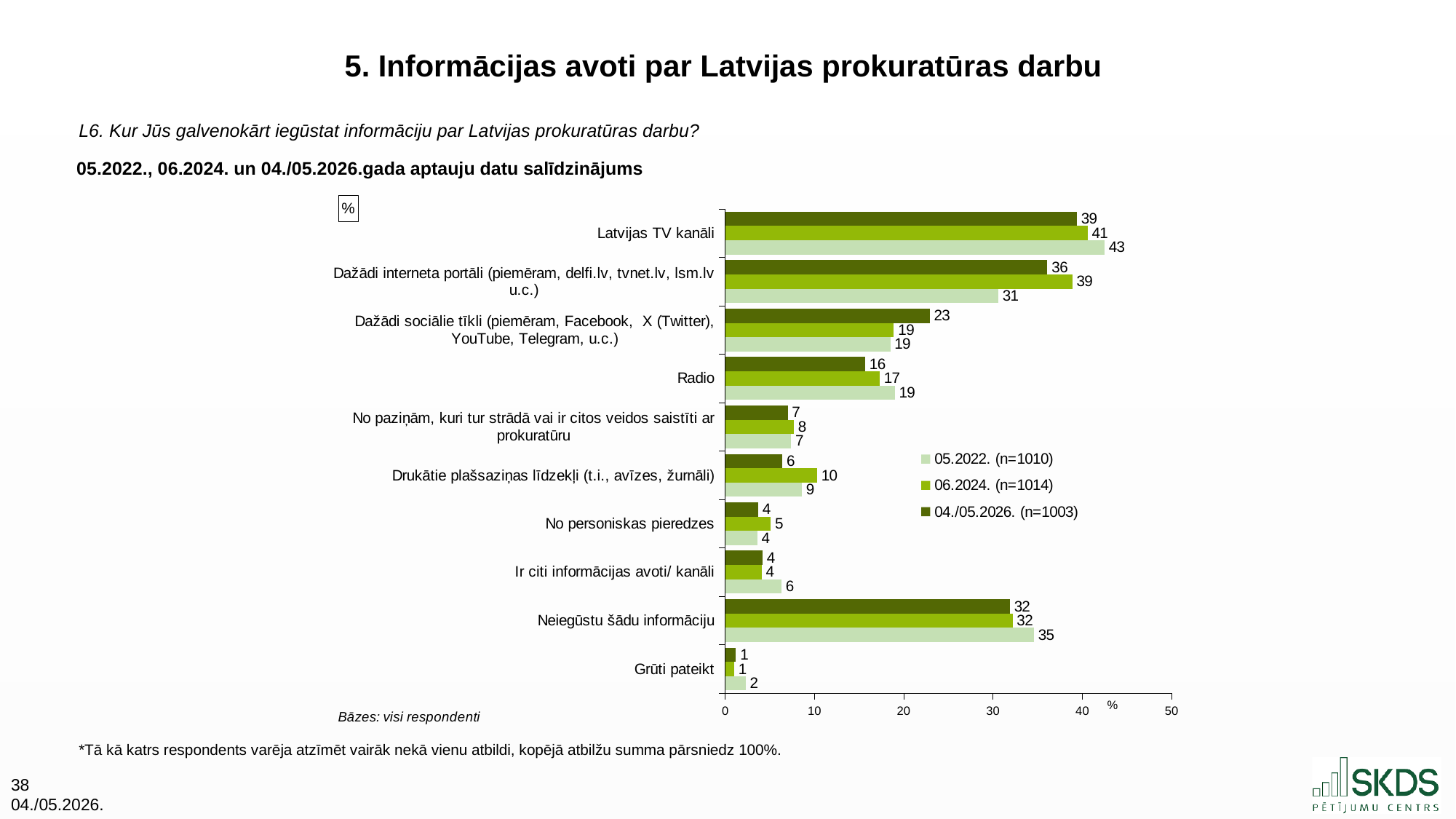
How many categories are shown on the chart? 10 What is the value for Latvijas TV kanāli in the 05.2022. survey? 43 What is the value for Dažādi interneta portāli in the 06.2024. survey? 39 What kind of chart is shown on the slide? bar chart For Dažādi sociālie tīkli, which survey has the larger value: 04./05.2026. or 06.2024.? 04./05.2026. What is the value for Radio in the 04./05.2026. survey? 16 What is the difference between the 06.2024. and 04./05.2026. values for Drukātie plašsaziņas līdzekļi? 4 Which category has the highest value in the 04./05.2026. series? Latvijas TV kanāli Which category has the lowest value in the 05.2022. series? Grūti pateikt How many series does the legend list? 3 What is the sample size (n) shown in the legend for the 06.2024. survey? n=1014 What is the difference between the 05.2022. and 04./05.2026. values for Latvijas TV kanāli? 4